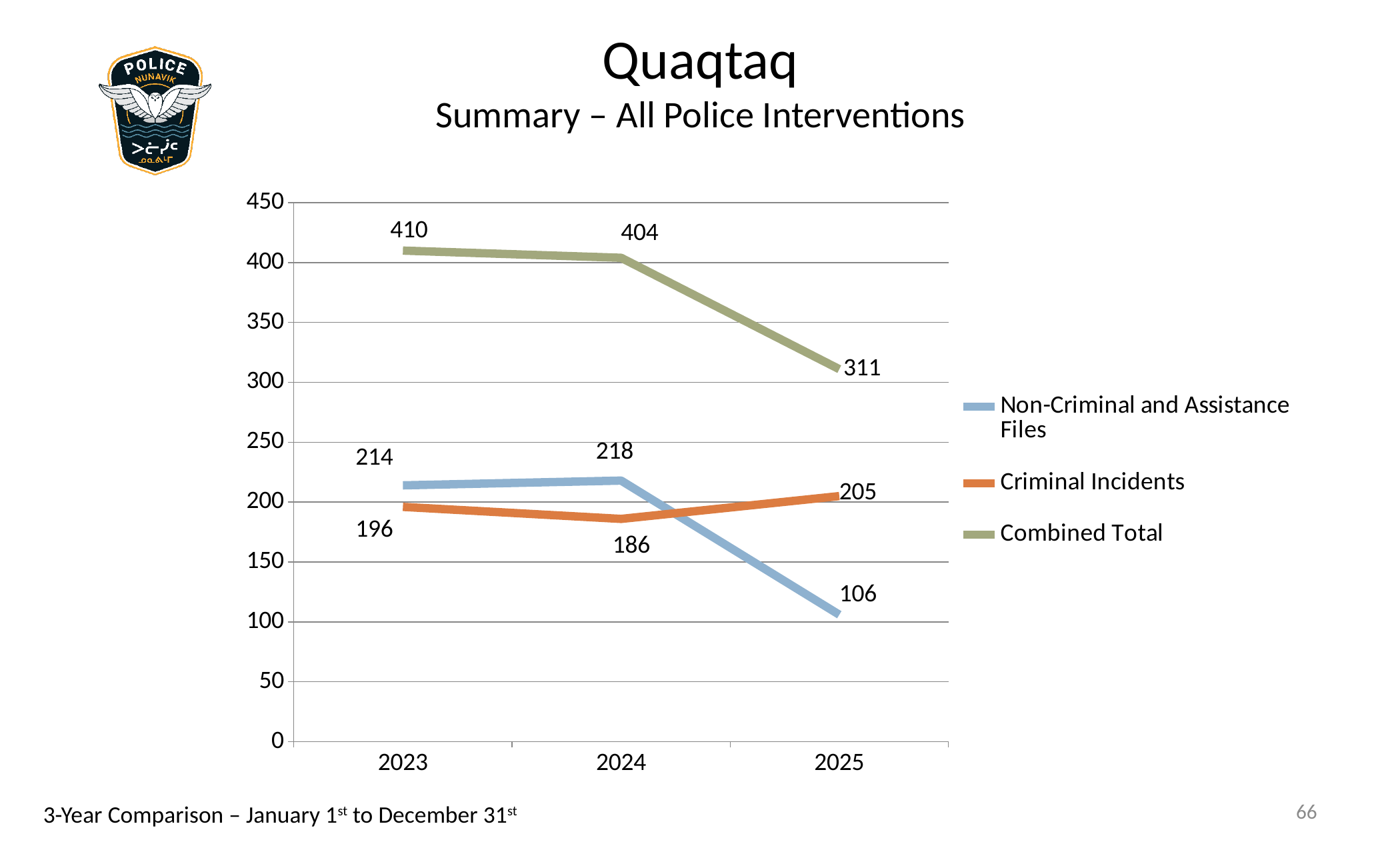
What is the Combined Total value for 2023? 410 In which year is the Non-Criminal and Assistance Files value highest? 2024 Does the Criminal Incidents value rise or fall from 2024 to 2025? Rise Which is larger in 2025: Criminal Incidents or Non-Criminal and Assistance Files? Criminal Incidents How many series does the legend list? 3 How many years are shown on the x axis? 3 What kind of chart is shown on the slide? Line chart What is the value for Criminal Incidents in 2024? 186 What is the difference between the Combined Total in 2024 and in 2025? 93 Is the Combined Total for 2025 greater or less than 300? greater In which year is the Combined Total lowest? 2025 What is the value for Non-Criminal and Assistance Files in 2025? 106